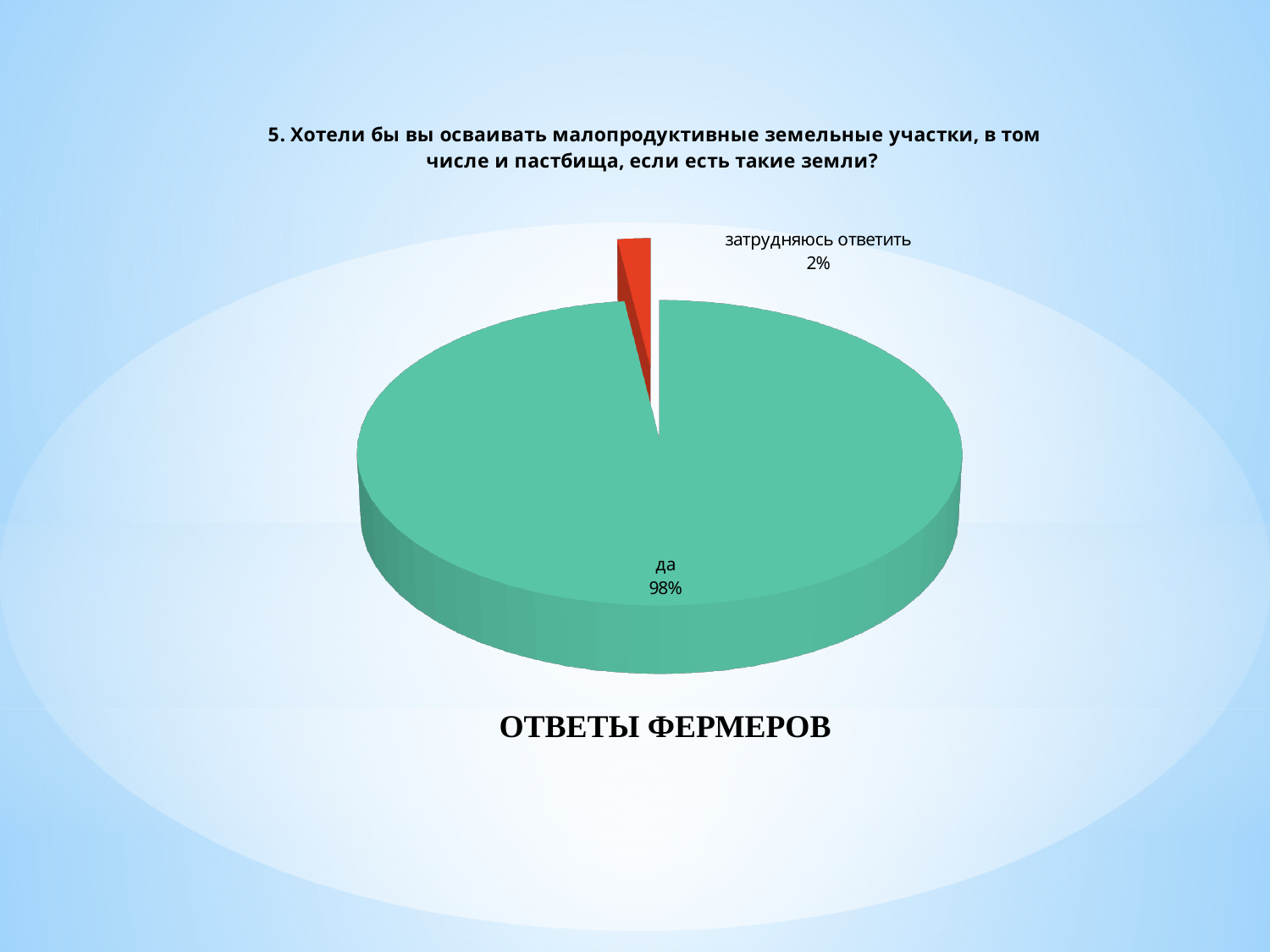
Which is larger: the "да" slice or the "затрудняюсь ответить" slice? да Which slice of the pie is the largest? да What is the total of the two slice percentages shown on the pie chart? 100% Which slice of the pie is the smallest? затрудняюсь ответить What is the difference in percentage points between the "да" slice and the "затрудняюсь ответить" slice? 96 What is the caption printed below the pie chart? ОТВЕТЫ ФЕРМЕРОВ What colour is the "затрудняюсь ответить" slice? red What share of the pie does the "да" slice represent? 98% How many slices does the pie chart have? 2 What share of the pie does the "затрудняюсь ответить" slice represent? 2% What kind of chart is shown on the slide? pie chart